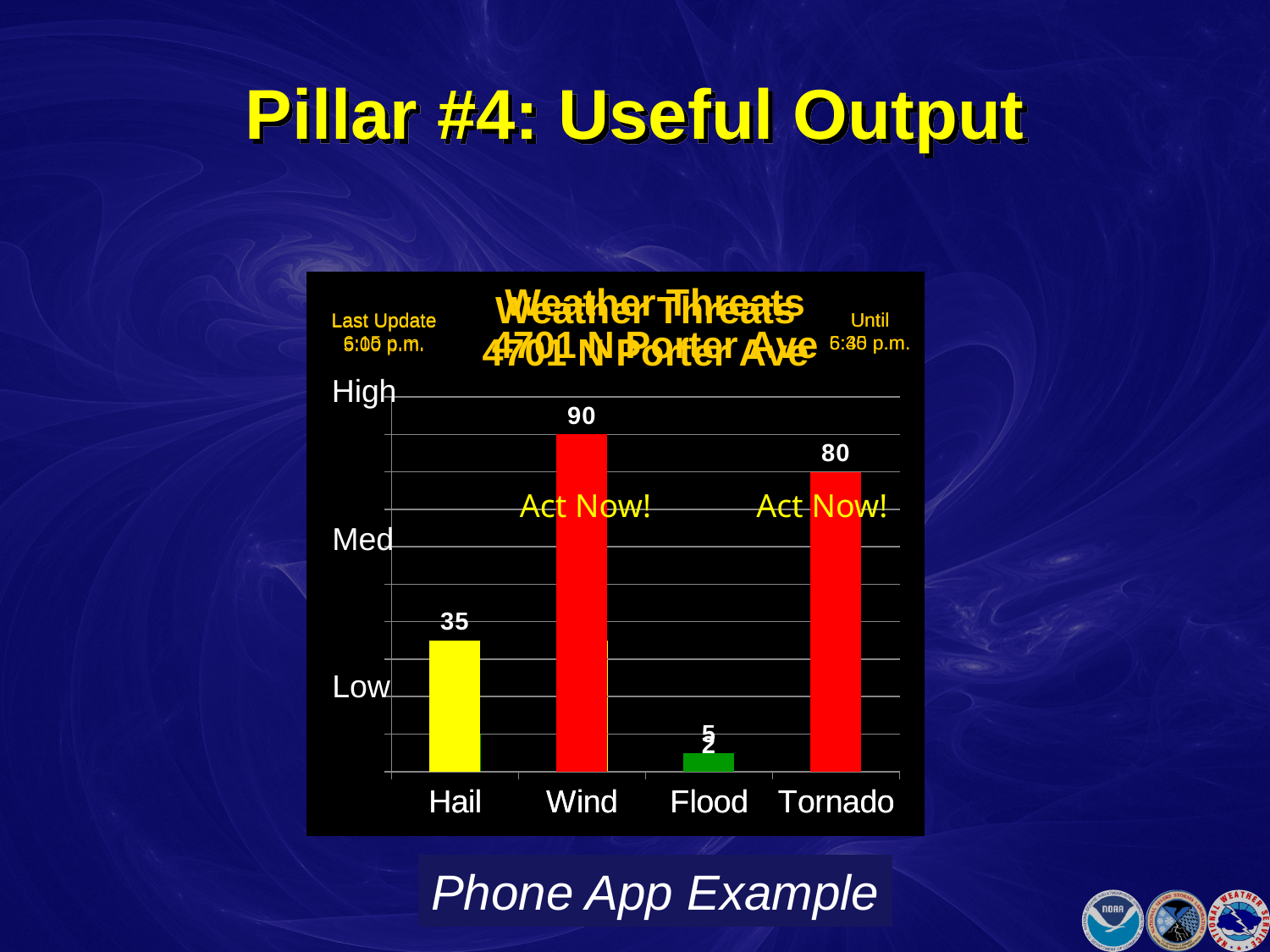
What is the value for Wind? 90 Which is larger, the value for Hail or the value for Tornado? Tornado Which category has the highest value? Wind What colour is the Hail bar? Yellow What is the difference between the values for Wind and Hail? 55 What is the value for Tornado? 80 Which category has the lowest value? Flood What is the difference between the values for Wind and Tornado? 10 What is the value for Hail? 35 How many categories are shown on the x axis? 4 What kind of chart is shown? Bar chart What text is shown above the Wind and Tornado bars? Act Now!